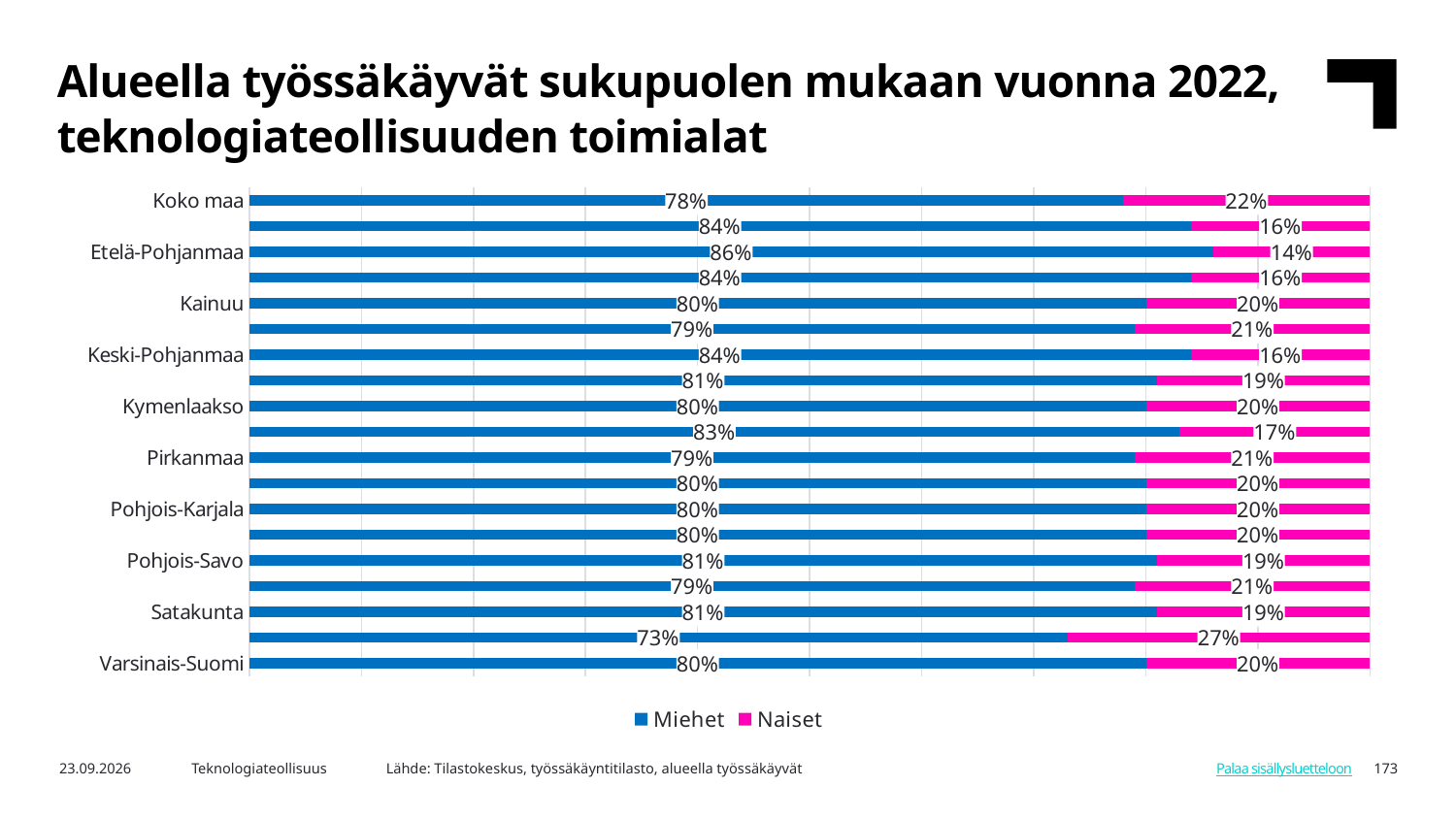
What is the Miehet share for Keski-Pohjanmaa? 84% What is the Miehet share for Koko maa? 78% What is the Naiset share for Pohjois-Savo? 19% Which has a larger Naiset share, Koko maa or Pirkanmaa? Koko maa Which has a larger Miehet share, Keski-Pohjanmaa or Kainuu? Keski-Pohjanmaa Which colour represents the Naiset series? Pink (magenta) How many series does the legend list? 2 Which labelled region has the highest Miehet share? Etelä-Pohjanmaa What kind of chart is shown on the slide? Stacked horizontal bar chart What is the Naiset share for Etelä-Pohjanmaa? 14% What is the difference between the Miehet and Naiset shares for Etelä-Pohjanmaa? 72 percentage points What is the total of the stacked bar for Satakunta? 100%